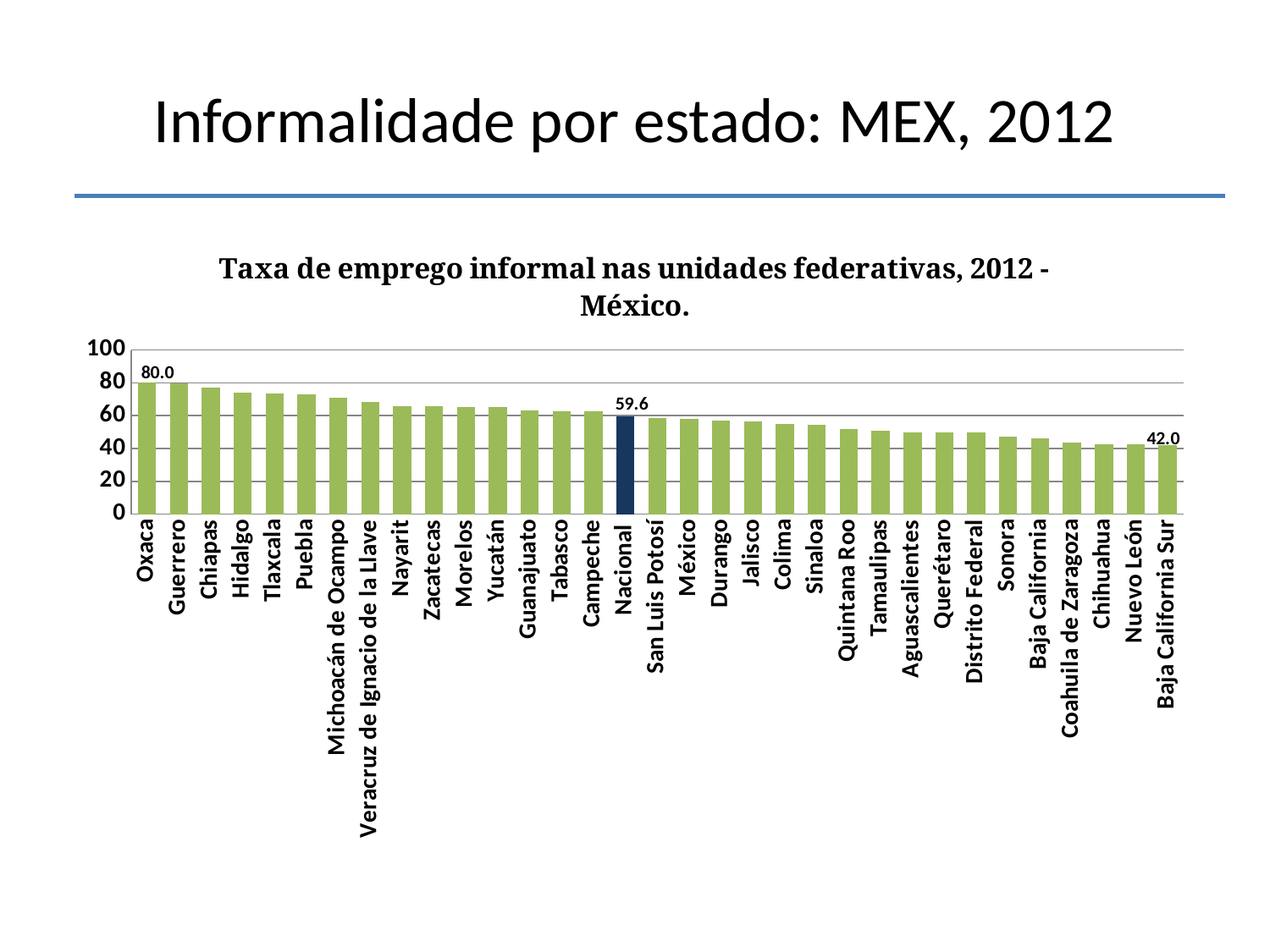
What is the value for Baja California Sur? 42.0 What kind of chart is shown on the slide? Bar chart How many bars are shown in the chart? 33 What is the difference between the values for Oaxaca and Baja California Sur? 38.0 Is the value for Chiapas greater or less than 60? greater What is the value for Nacional? 59.6 What is the difference between the values for Nacional and Baja California Sur? 17.6 What is the difference between the values for Oaxaca and Nacional? 20.4 What is the value for Oaxaca? 80.0 Which is larger, the value for Hidalgo or the value for Quintana Roo? Hidalgo Is the value for Sonora greater or less than 60? less Do the values rise or fall from left to right along the x axis? Fall